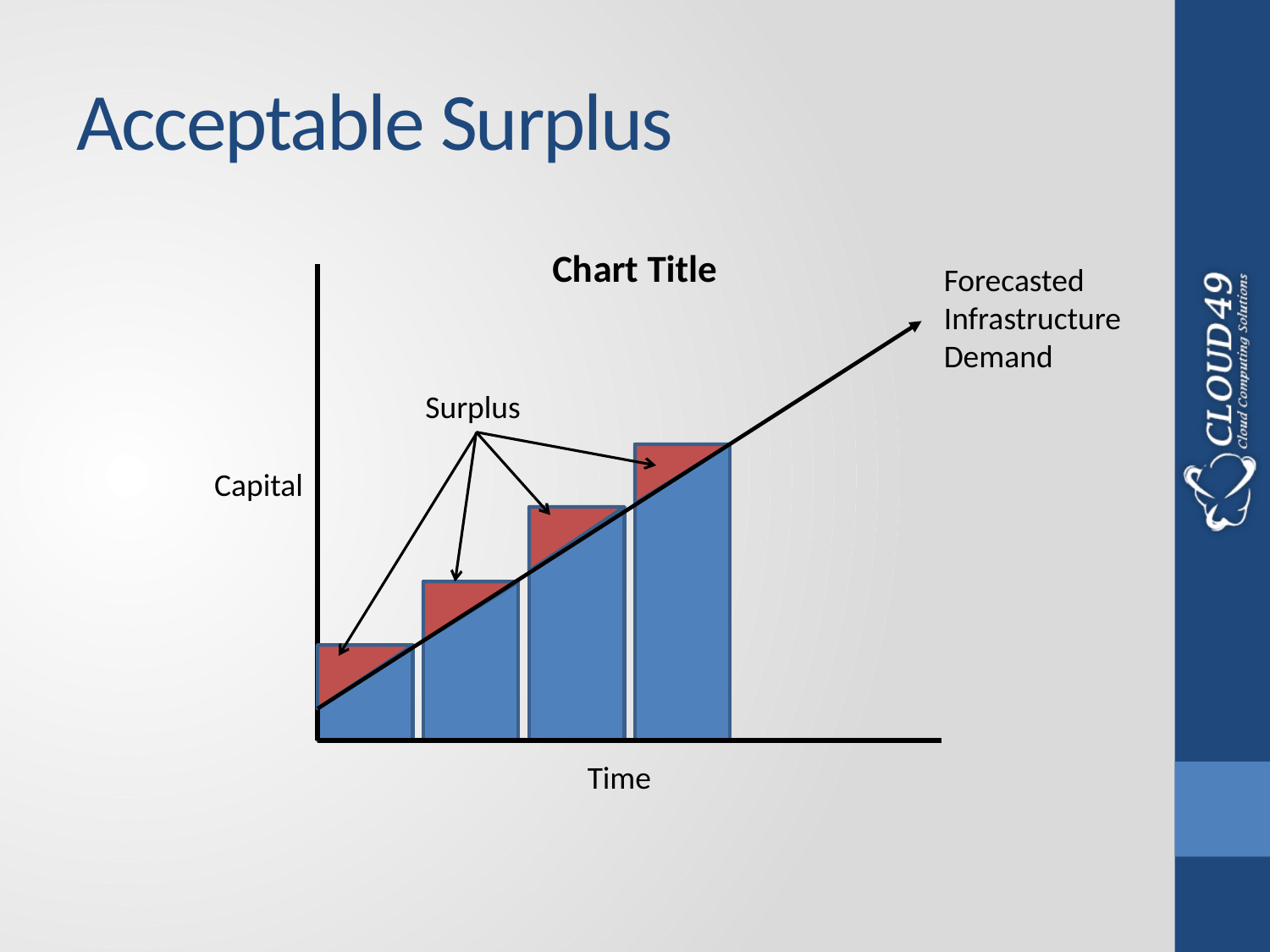
What label is shown on the vertical axis of the chart? Capital What is the title printed above the chart? Chart Title What does the diagonal arrow line in the chart represent, according to its label? Forecasted Infrastructure Demand Do the bar heights rise or fall from left to right along the Time axis? Rise Which bar is the shortest: the leftmost or the rightmost? The leftmost How many bars are plotted in the chart? 4 What kind of chart is shown on the slide? Bar chart Is the second bar from the left taller or shorter than the third bar from the left? Shorter Which bar is the tallest: the leftmost or the rightmost? The rightmost